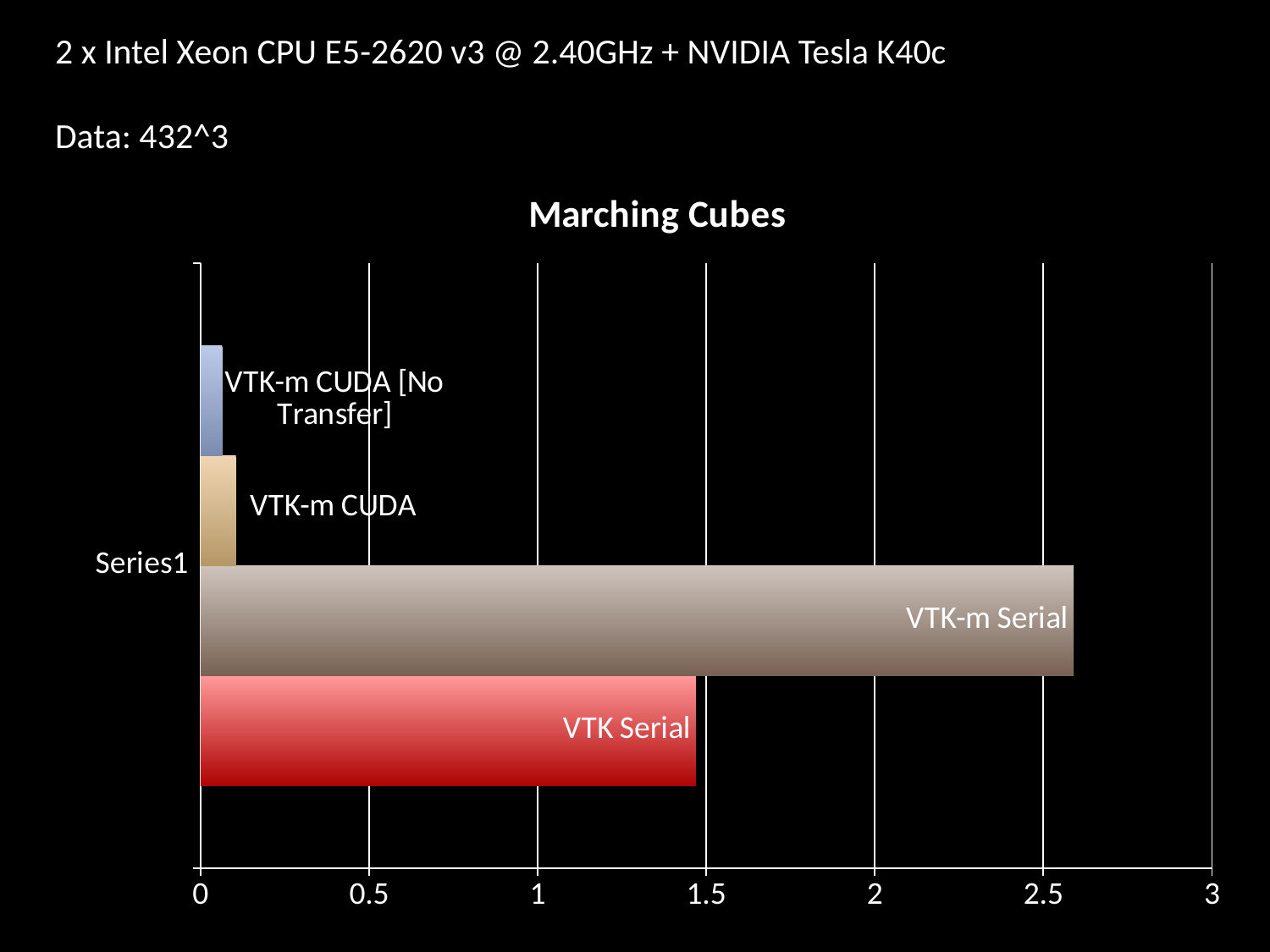
What is the title of the chart? Marching Cubes Which bar has the highest value? VTK-m Serial Is the value for VTK-m Serial greater or less than 2.5? greater Is the value for VTK Serial greater or less than 1? greater Which is larger, the value for VTK Serial or the value for VTK-m CUDA? VTK Serial Which bar has the lowest value? VTK-m CUDA [No Transfer] What kind of chart is shown on the slide? bar chart Is the value for VTK Serial greater or less than 1.5? less What is the highest value shown on the horizontal axis? 3 Which is larger, the value for VTK-m Serial or the value for VTK Serial? VTK-m Serial How many bars are plotted in the chart? 4